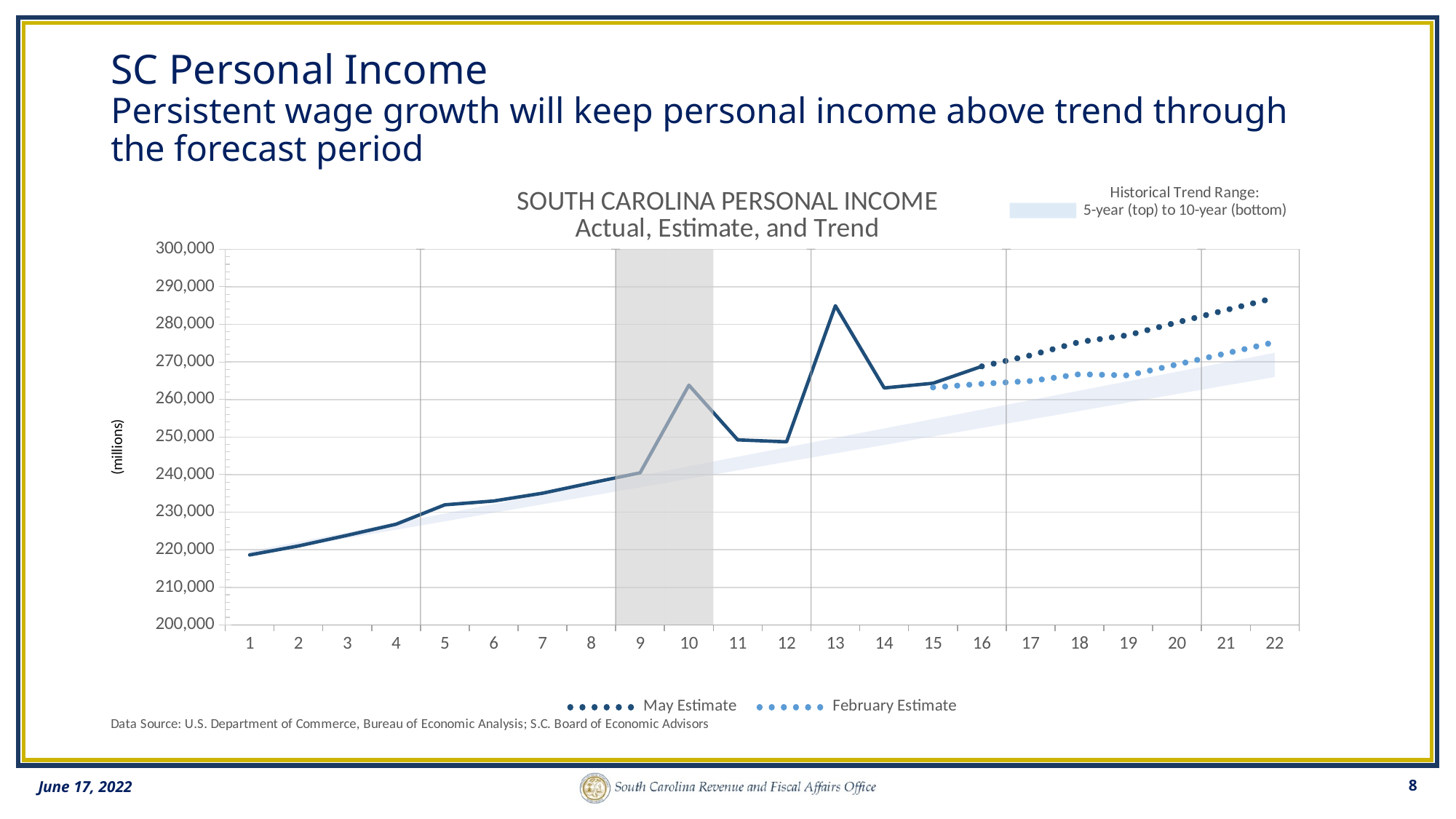
What kind of chart is shown on the slide? Line chart Does the actual line rise or fall from point 1 to point 8? Rise At which x-axis point does the solid actual line reach its highest value? 13 At point 22, which is higher: the May Estimate or the February Estimate? May Estimate What unit is shown on the y axis of the chart? (millions) How many series does the legend below the chart list? 2 Is the February Estimate value at point 22 greater or less than 280,000? less How many points are labelled along the x axis? 22 Is the value of the actual line at point 10 greater or less than 260,000? greater Is the value of the actual line at point 13 greater or less than 280,000? greater